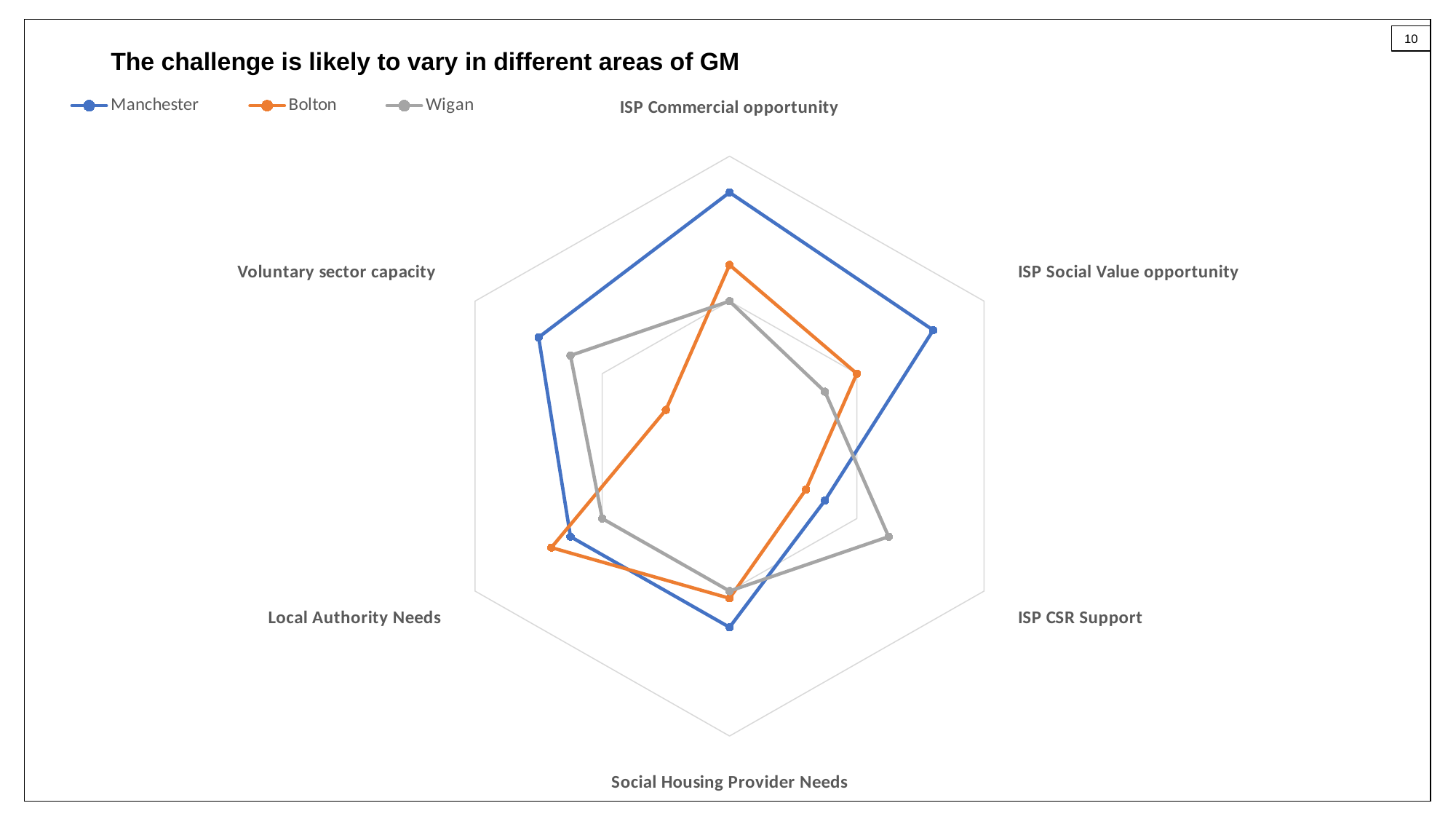
Which area has the highest value for ISP CSR Support? Wigan For Bolton, is the value for Voluntary sector capacity larger or smaller than the value for Local Authority Needs? Smaller Which area has the lowest value for ISP Commercial opportunity? Wigan Which area has the highest value for ISP Commercial opportunity? Manchester Which colour represents Bolton in the chart? Orange Which area has the highest value for ISP Social Value opportunity? Manchester How many series does the legend list? 3 What kind of chart is shown on the slide? Radar chart How many categories (axes) does the radar chart have? 6 Which area has the lowest value for Voluntary sector capacity? Bolton